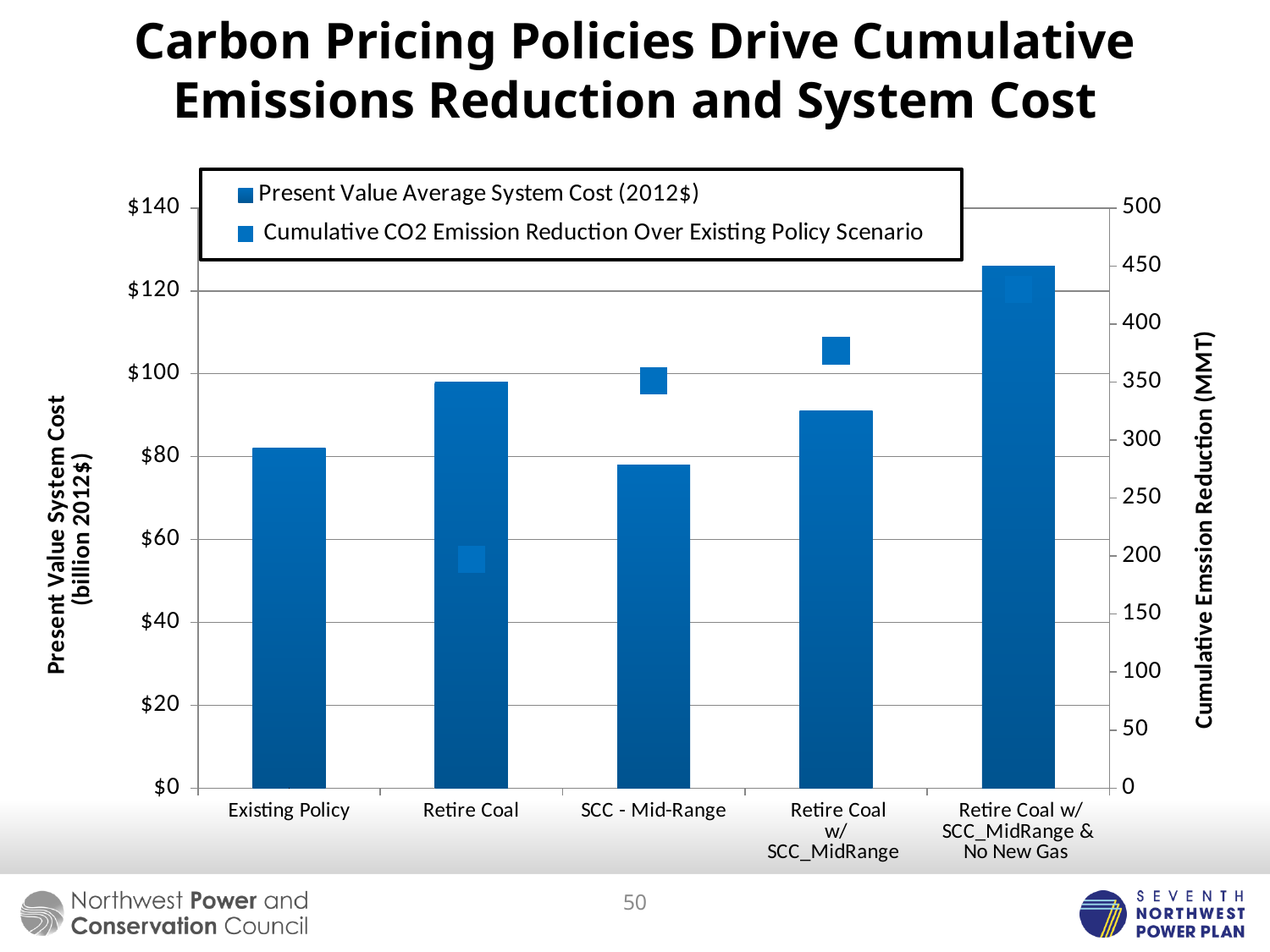
What is the title of the slide? Carbon Pricing Policies Drive Cumulative Emissions Reduction and System Cost Is the Present Value Average System Cost for Existing Policy greater or less than $100? less Which scenario has the lowest Present Value Average System Cost? SCC - Mid-Range What kind of chart is shown on the slide? combination bar and line chart (bars with a second series plotted as markers) Which has a higher Present Value Average System Cost, Retire Coal or Existing Policy? Retire Coal How many scenario categories are shown on the x axis? 5 Is the Present Value Average System Cost for Retire Coal w/ SCC_MidRange & No New Gas greater or less than $120? greater What is the label of the right-hand vertical axis? Cumulative Emssion Reduction (MMT) Is the Present Value Average System Cost for SCC - Mid-Range greater or less than $80? less Which scenario has the highest Present Value Average System Cost? Retire Coal w/ SCC_MidRange & No New Gas How many series does the legend list? 2 Which scenario has the highest Cumulative CO2 Emission Reduction Over Existing Policy Scenario? Retire Coal w/ SCC_MidRange & No New Gas